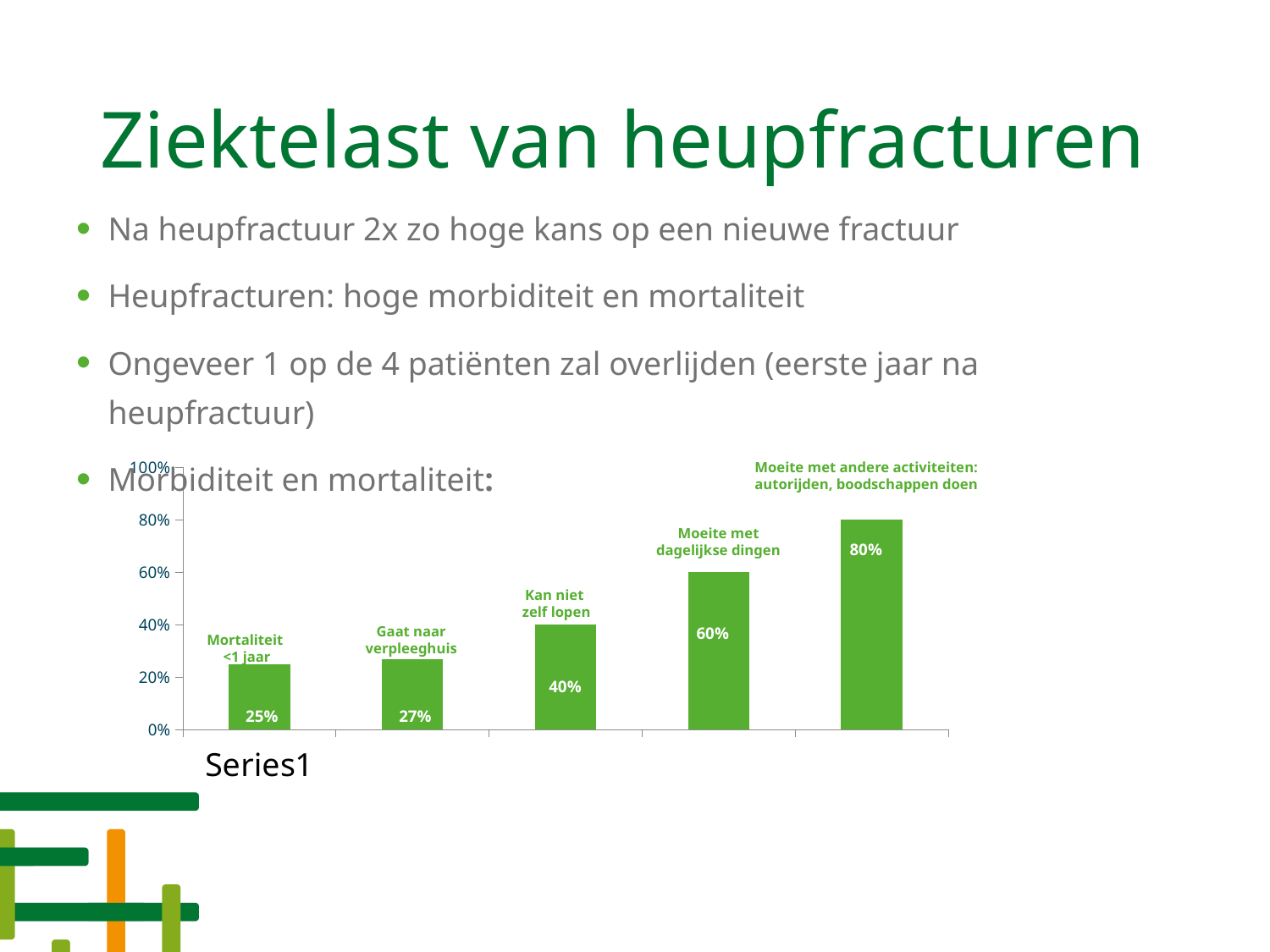
Which is larger, the value for "Moeite met dagelijkse dingen" or the value for "Kan niet zelf lopen"? Moeite met dagelijkse dingen What is the value for "Moeite met dagelijkse dingen"? 60% Which category has the highest value? Moeite met andere activiteiten: autorijden, boodschappen doen Which category has the lowest value? Mortaliteit <1 jaar What is the difference between the values for "Moeite met andere activiteiten" and "Kan niet zelf lopen"? 40% What kind of chart is shown on the slide? Bar chart Do the bar values rise or fall from left to right? Rise What is the value for "Mortaliteit <1 jaar"? 25% How many bars are shown in the chart? 5 What is the value for "Kan niet zelf lopen"? 40% What is the value for "Gaat naar verpleeghuis"? 27%